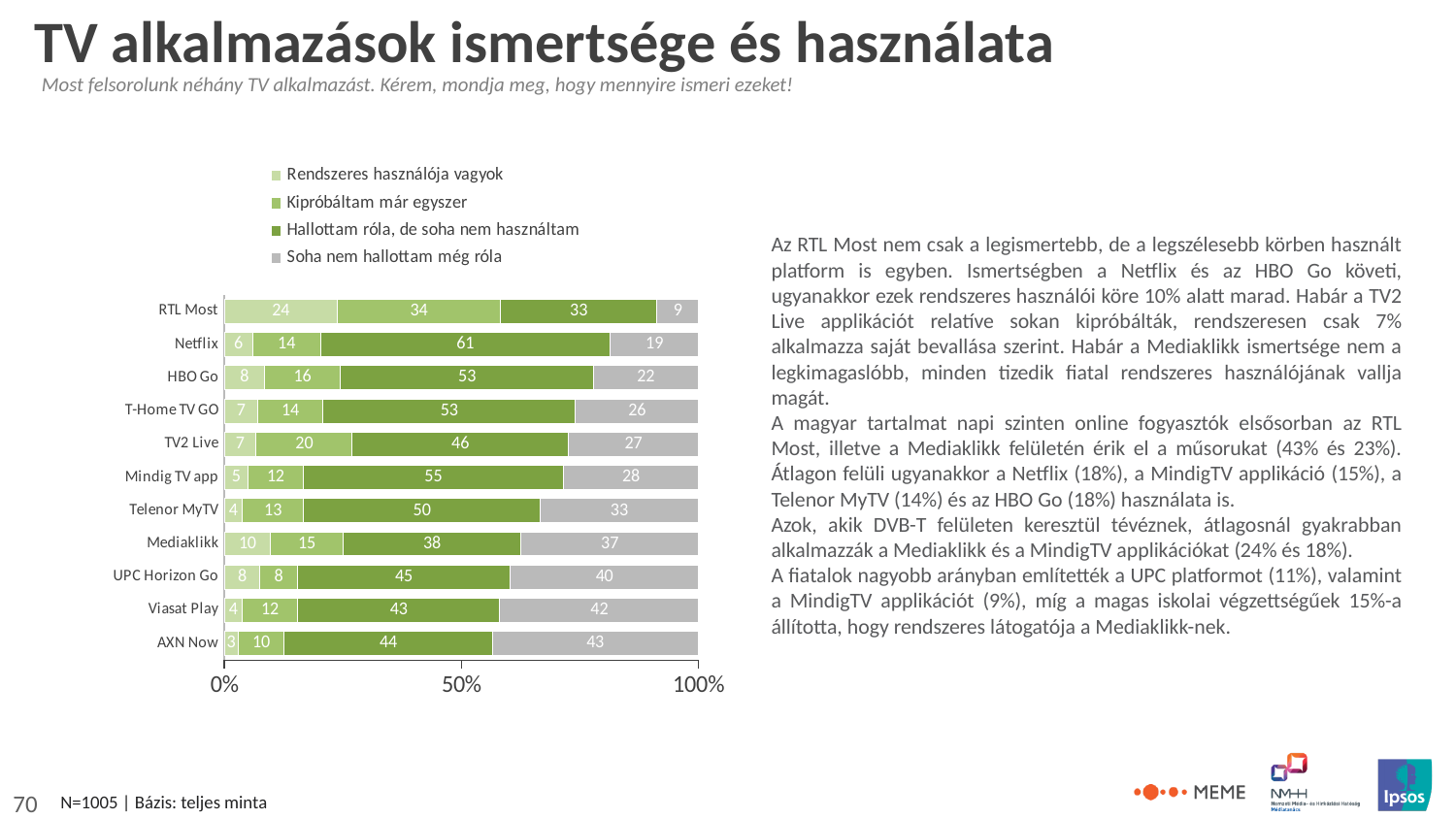
Which application has the lowest value for 'Soha nem hallottam még róla'? RTL Most How many TV applications (categories) are listed on the chart? 11 What is the difference between the 'Kipróbáltam már egyszer' values for TV2 Live and Mindig TV app? 8 What is the total of the stacked bar for HBO Go? 99 What is the value of 'Soha nem hallottam még róla' for AXN Now? 43 What is the value of 'Rendszeres használója vagyok' for RTL Most? 24 Which legend entry is shown in grey? Soha nem hallottam még róla Which application has the highest value for 'Rendszeres használója vagyok'? RTL Most What is the value of 'Hallottam róla, de soha nem használtam' for Netflix? 61 Which has a larger 'Soha nem hallottam még róla' value, Mediaklikk or UPC Horizon Go? UPC Horizon Go How many series does the chart legend list? 4 What type of chart is shown on the slide? Stacked bar chart